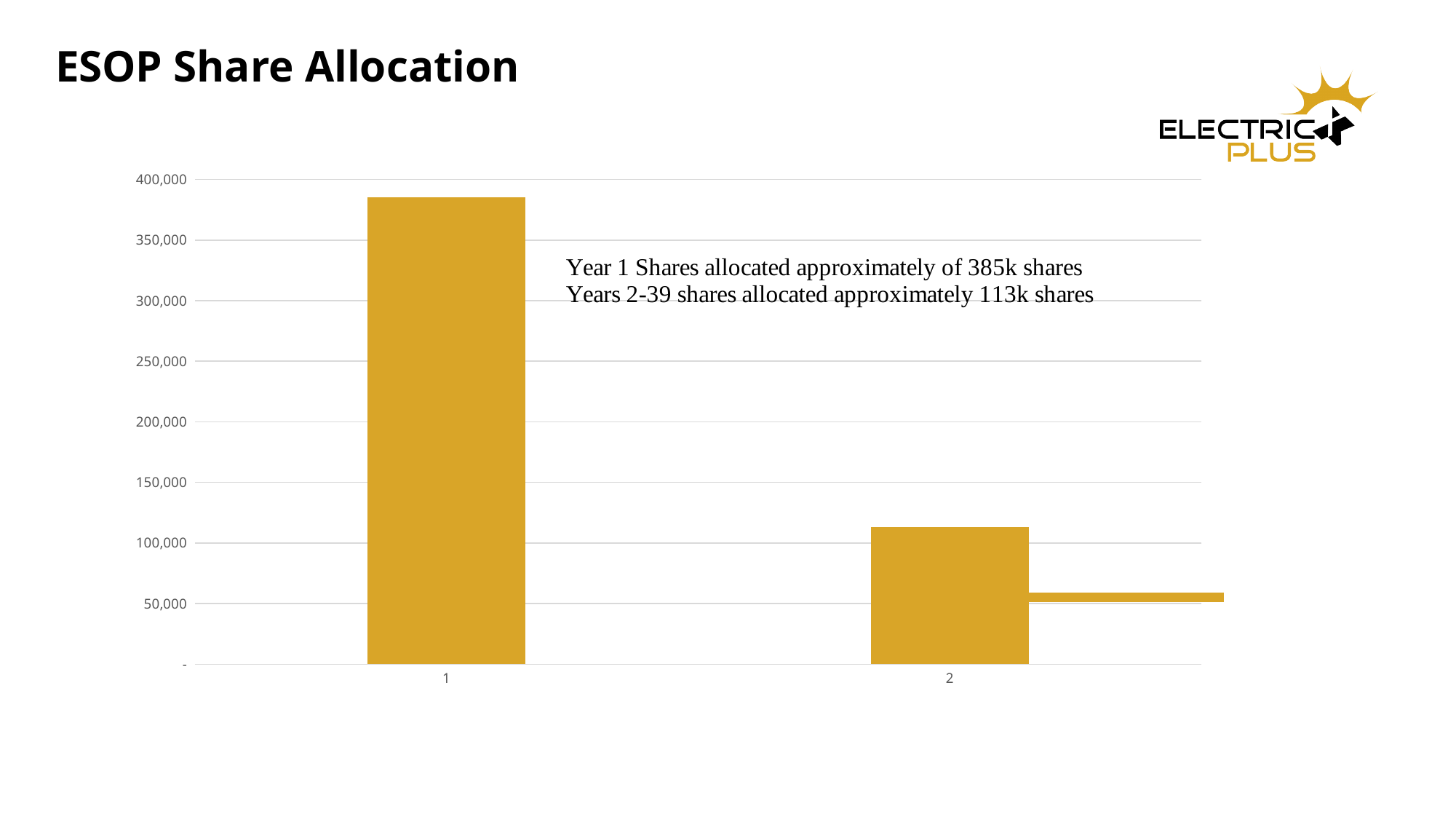
Is the value for category 2 greater or less than 100,000? greater What kind of chart is shown on the slide? bar chart Which category has the lowest bar in the chart? 2 Do the bar values rise or fall from category 1 to category 2? fall What is the highest value shown on the y axis of the chart? 400,000 Is the value for category 1 greater or less than 400,000? less How many categories are labelled on the x axis of the chart? 2 What is the title of the slide containing the chart? ESOP Share Allocation Which is larger, the bar for category 1 or the bar for category 2? 1 Which category has the highest bar in the chart? 1 Is the value for category 2 greater or less than 150,000? less